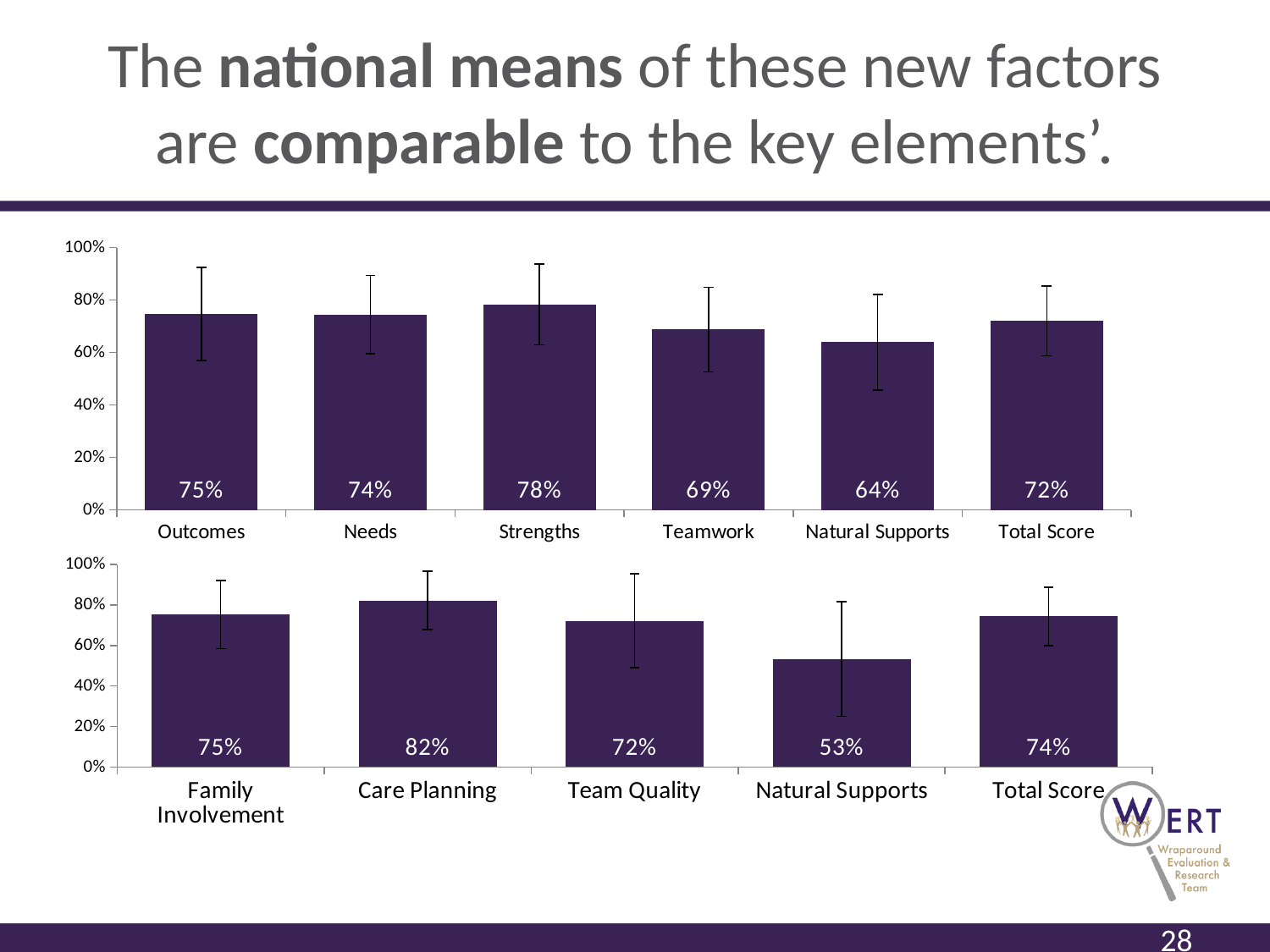
In the bottom chart, which is larger, the value for Family Involvement or the value for Natural Supports? Family Involvement In the top chart, what is the difference between the values for Strengths and Natural Supports? 14% In the bottom chart, which category has the lowest value? Natural Supports What kind of chart is the bottom chart? Bar chart In the bottom chart, what is the value for Natural Supports? 53% In the bottom chart, what is the difference between the values for Care Planning and Team Quality? 10% How many categories are shown in the top chart? 6 In the top chart, what is the value for Strengths? 78% In the bottom chart, what is the value for Care Planning? 82% In the top chart, which category has the highest value? Strengths How many categories are shown in the bottom chart? 5 In the top chart, what is the value for Natural Supports? 64%